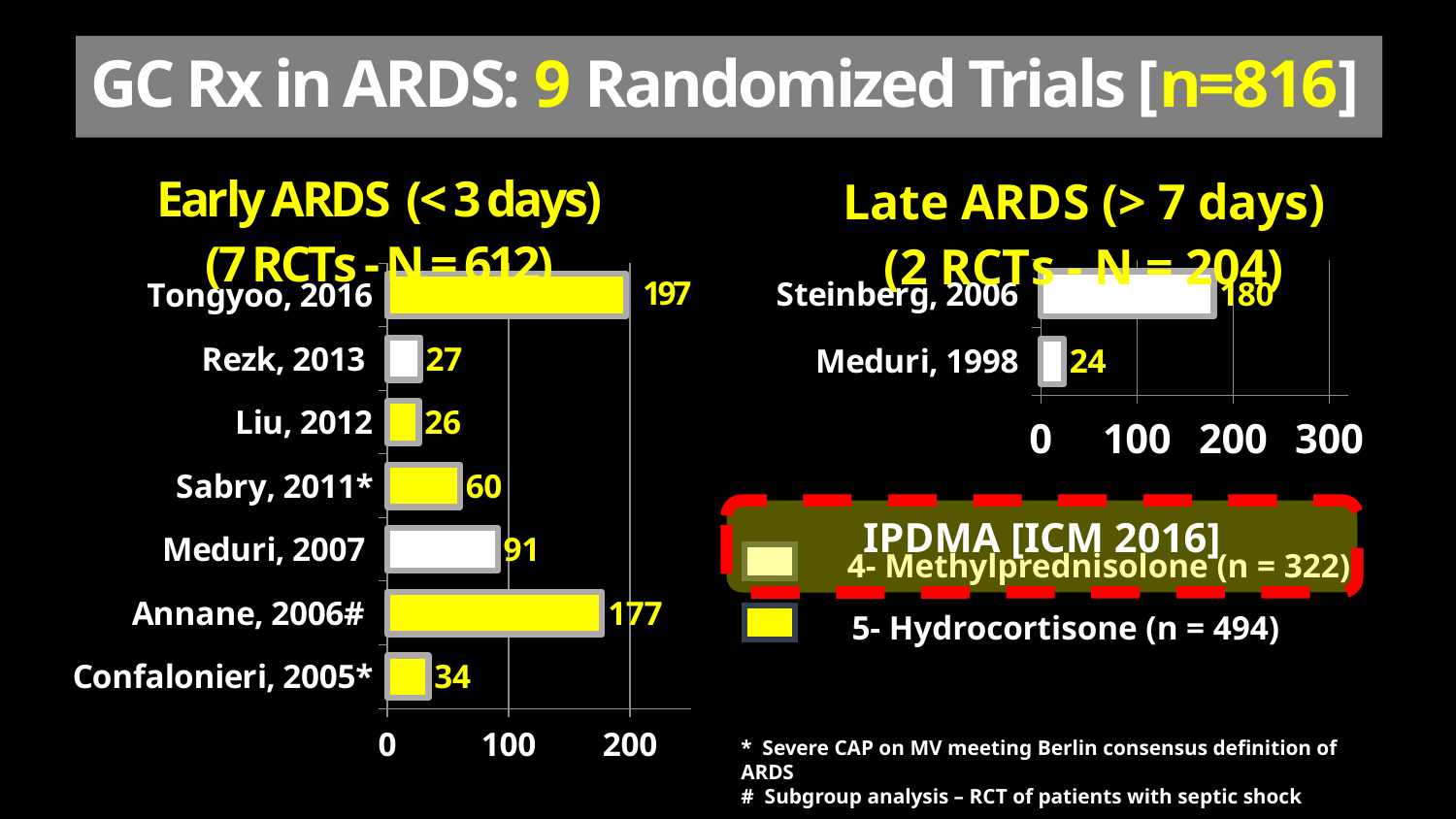
In the Late ARDS (> 7 days) chart, what is the value for Steinberg, 2006? 180 In the Late ARDS (> 7 days) chart, what is the difference between Steinberg, 2006 and Meduri, 1998? 156 In the Early ARDS (< 3 days) chart, what is the difference between Tongyoo, 2016 and Annane, 2006#? 20 In the Early ARDS (< 3 days) chart, which is larger, Sabry, 2011* or Confalonieri, 2005*? Sabry, 2011* In the Early ARDS (< 3 days) chart, what is the value for Tongyoo, 2016? 197 In the Early ARDS (< 3 days) chart, what is the value for Meduri, 2007? 91 How many trials are shown in the Early ARDS (< 3 days) chart? 7 In the Late ARDS (> 7 days) chart, what is the value for Meduri, 1998? 24 In the Early ARDS (< 3 days) chart, which trial has the highest value? Tongyoo, 2016 In the Early ARDS (< 3 days) chart, which trial has the lowest value? Liu, 2012 What type of chart is the Late ARDS (> 7 days) chart? Bar chart